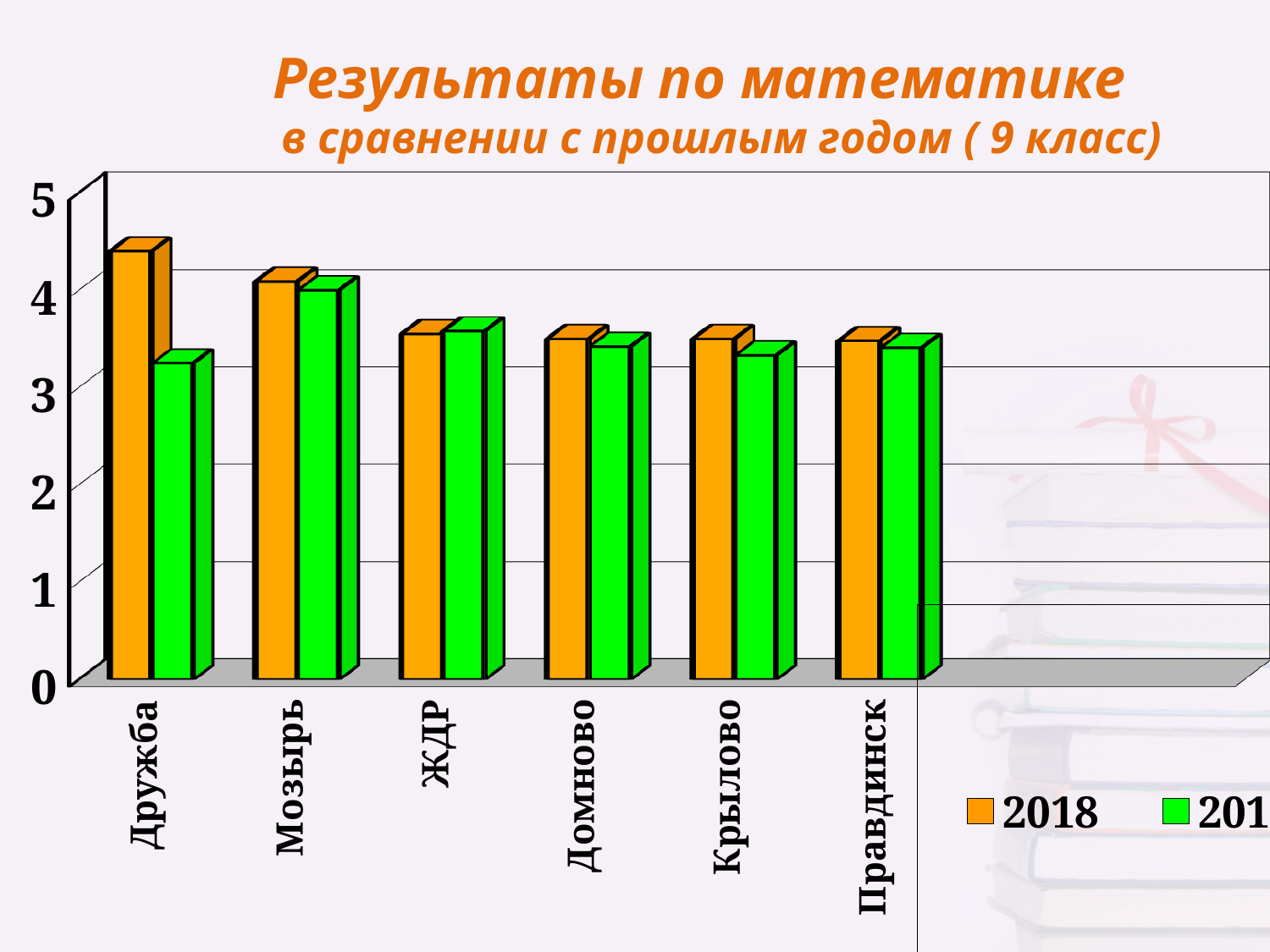
How many categories (schools) are shown on the x axis? 6 Is the green-series value for Крылово greater or less than 3? greater What kind of chart is shown on the slide? bar chart Is the 2018 value for Дружба greater or less than 4? greater Is the green-series value for Дружба greater or less than 4? less For Дружба, which is larger: the 2018 value or the green-series value? 2018 Which is larger: the 2018 value for Дружба or the 2018 value for Мозырь? Дружба What colour are the bars for the 2018 series? orange What is the title of the chart? Результаты по математике в сравнении с прошлым годом ( 9 класс) Which category has the highest value for the 2018 series? Дружба Which category has the highest value for the green series? Мозырь How many series does the legend list? 2